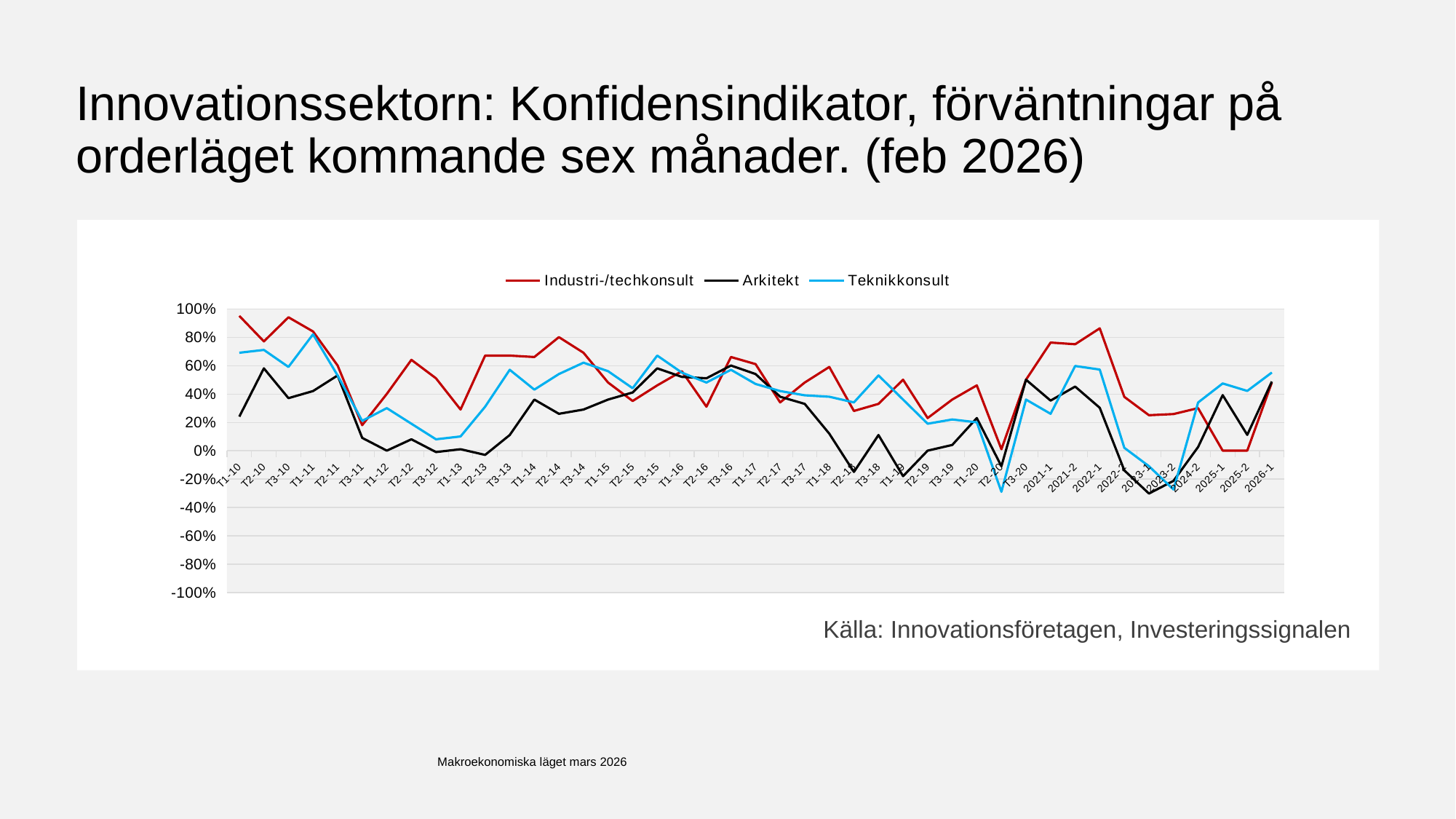
What source is cited below the chart? Innovationsföretagen, Investeringssignalen Is the value for Arkitekt at T1-10 greater or less than 40%? less Is the value for Teknikkonsult at T2-20 greater or less than -20%? less Is the value for Industri-/techkonsult at 2022-1 greater or less than 80%? greater Which series is drawn in black? Arkitekt At 2022-1, which is higher: Industri-/techkonsult or Arkitekt? Industri-/techkonsult What kind of chart is shown on the slide? line chart How many series does the legend list? 3 Does the Teknikkonsult line rise or fall from 2023-2 to 2026-1? rise At T1-10, which is higher: Industri-/techkonsult or Arkitekt? Industri-/techkonsult Which series reaches the highest value anywhere on the chart? Industri-/techkonsult